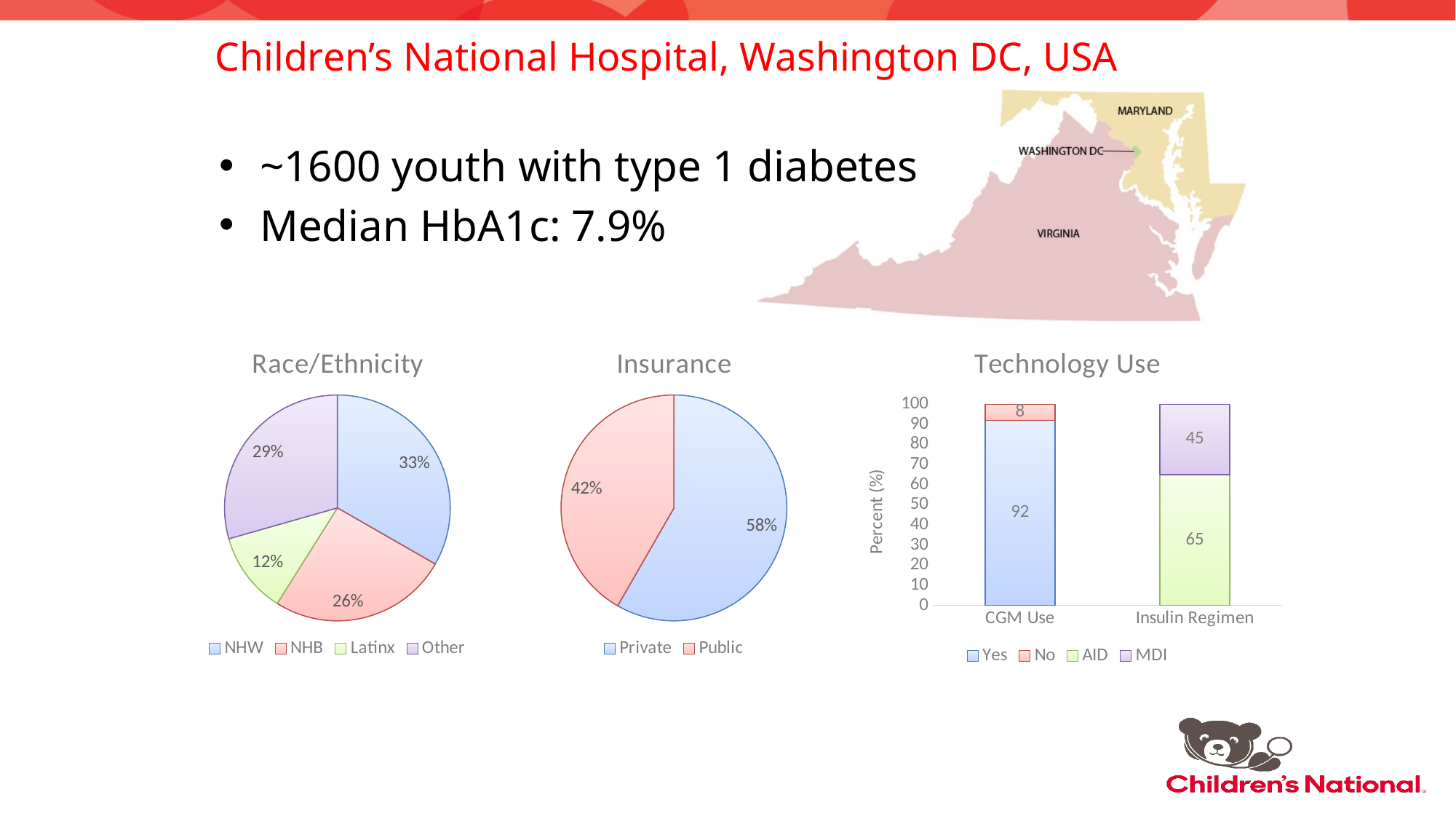
In the Technology Use chart, what is the value for MDI under Insulin Regimen? 45 In the Insurance pie chart, what is the difference between the Private and Public shares? 16% In the Technology Use chart, what is the value for Yes under CGM Use? 92 In the Insurance pie chart, which is larger, Private or Public? Private In the Technology Use chart, what is the total of the Insulin Regimen stacked bar? 110 In the Technology Use chart, how many series does the legend list? 4 In the Race/Ethnicity pie chart, which category has the smallest share? Latinx In the Race/Ethnicity pie chart, what share is Latinx? 12% In the Race/Ethnicity pie chart, what share is NHW? 33% In the Race/Ethnicity pie chart, how many categories are shown? 4 In the Insurance pie chart, what share is Public? 42% In the Race/Ethnicity pie chart, which category has the largest share? NHW